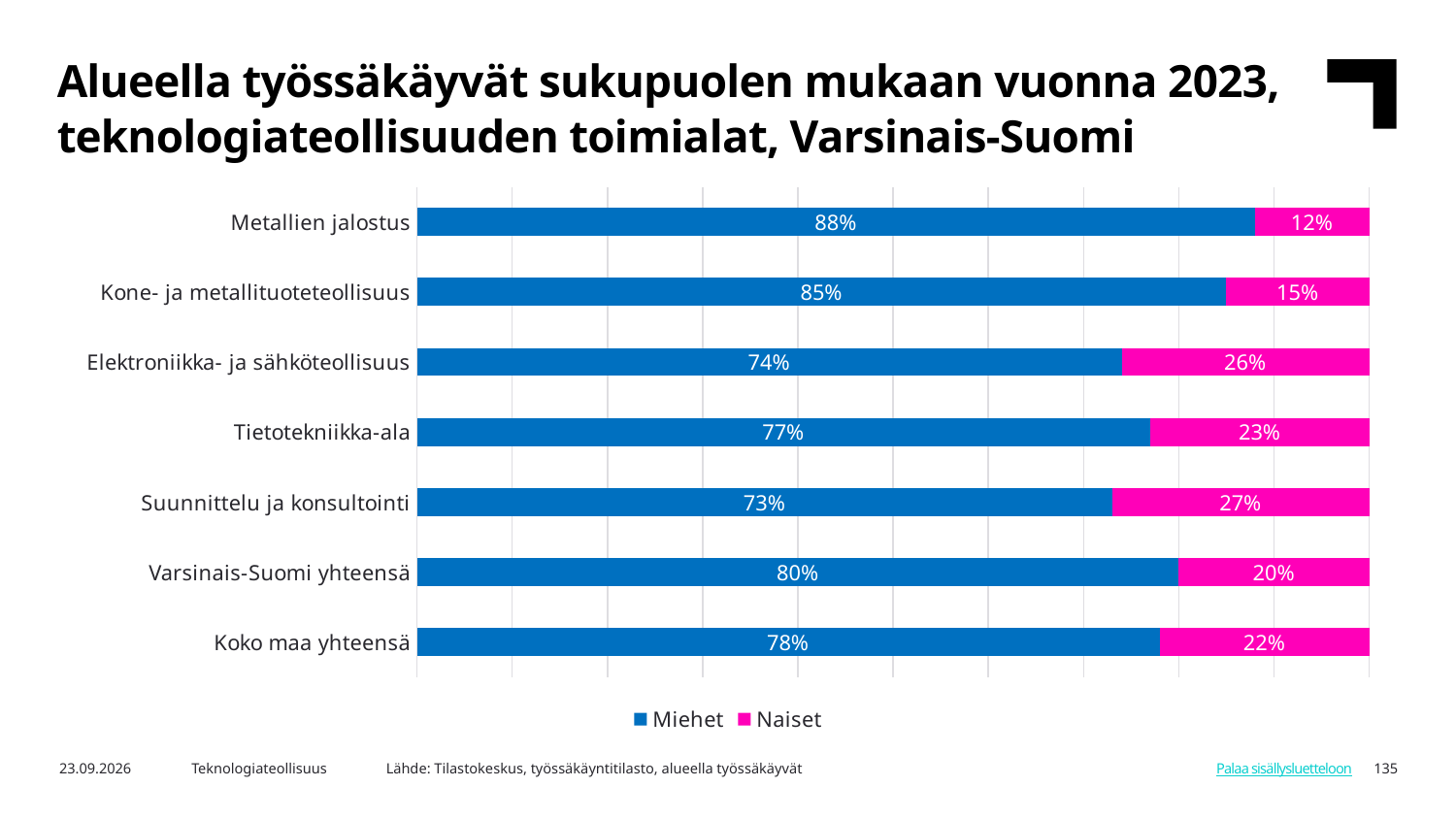
What is the Naiset share for Varsinais-Suomi yhteensä? 20% What is the total of the stacked bar for Suunnittelu ja konsultointi? 100% Which category has the highest Naiset share? Suunnittelu ja konsultointi What is the Miehet share for Koko maa yhteensä? 78% Which has a larger Naiset share, Tietotekniikka-ala or Koko maa yhteensä? Tietotekniikka-ala Which category has the lowest Naiset share? Metallien jalostus How many categories are shown on the chart? 7 What is the Miehet share for Metallien jalostus? 88% What is the Naiset share for Elektroniikka- ja sähköteollisuus? 26% What kind of chart is shown on the slide? Stacked bar chart What is the difference between the Miehet share for Kone- ja metallituoteteollisuus and for Tietotekniikka-ala? 8 percentage points How many series does the legend list? 2